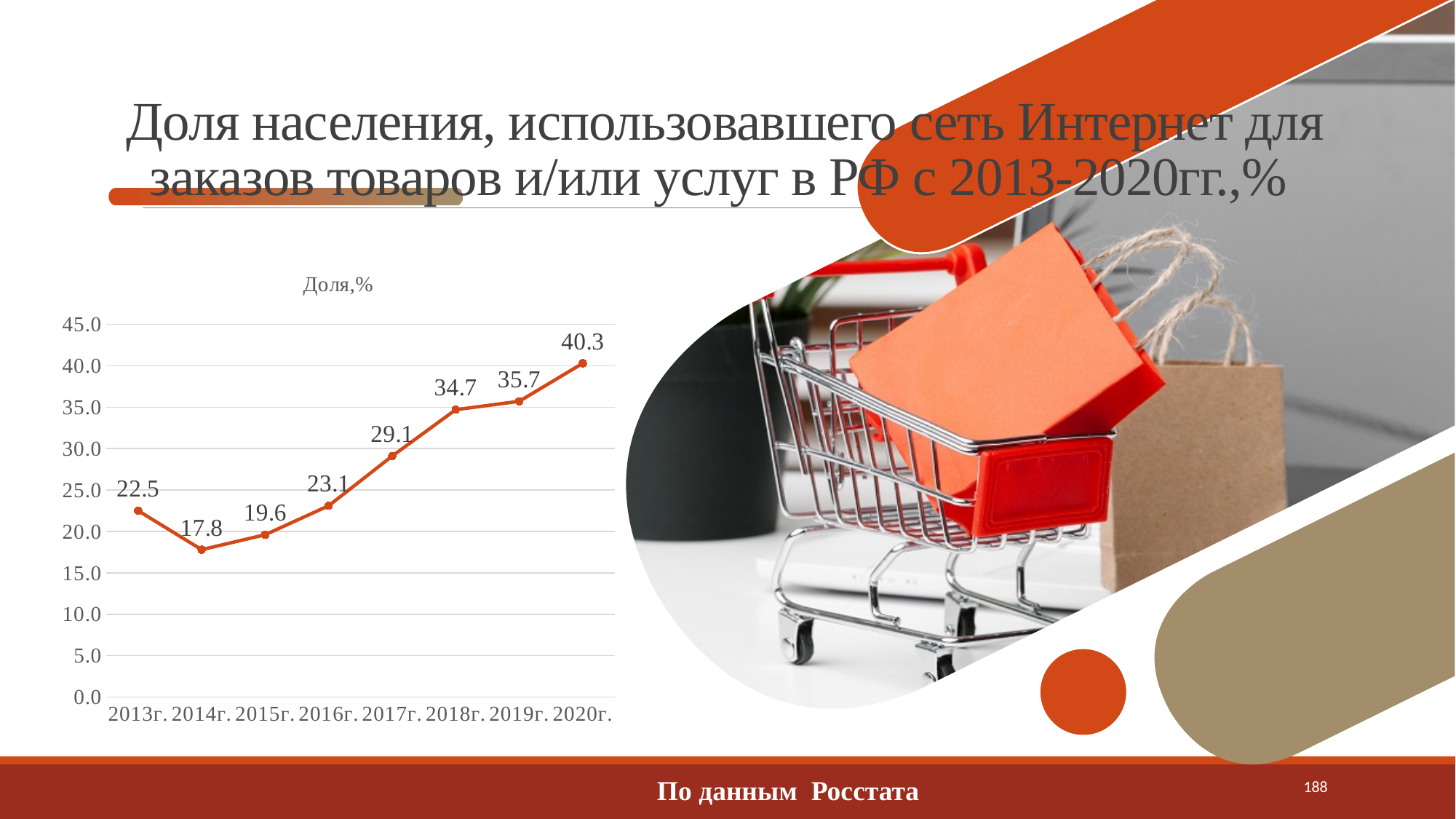
Is the value for 2019г. greater or less than 30.0? greater Which year has the lowest value? 2014г. What is the difference between the values for 2018г. and 2017г.? 5.6 Which is larger, the value for 2015г. or the value for 2016г.? 2016г. What kind of chart is shown on the slide? line chart What is the title of the chart? Доля,% What is the value for 2013г.? 22.5 What is the value for 2020г.? 40.3 What is the difference between the values for 2020г. and 2013г.? 17.8 How many years are plotted on the chart? 8 Which year has the highest value? 2020г. What is the value for 2017г.? 29.1